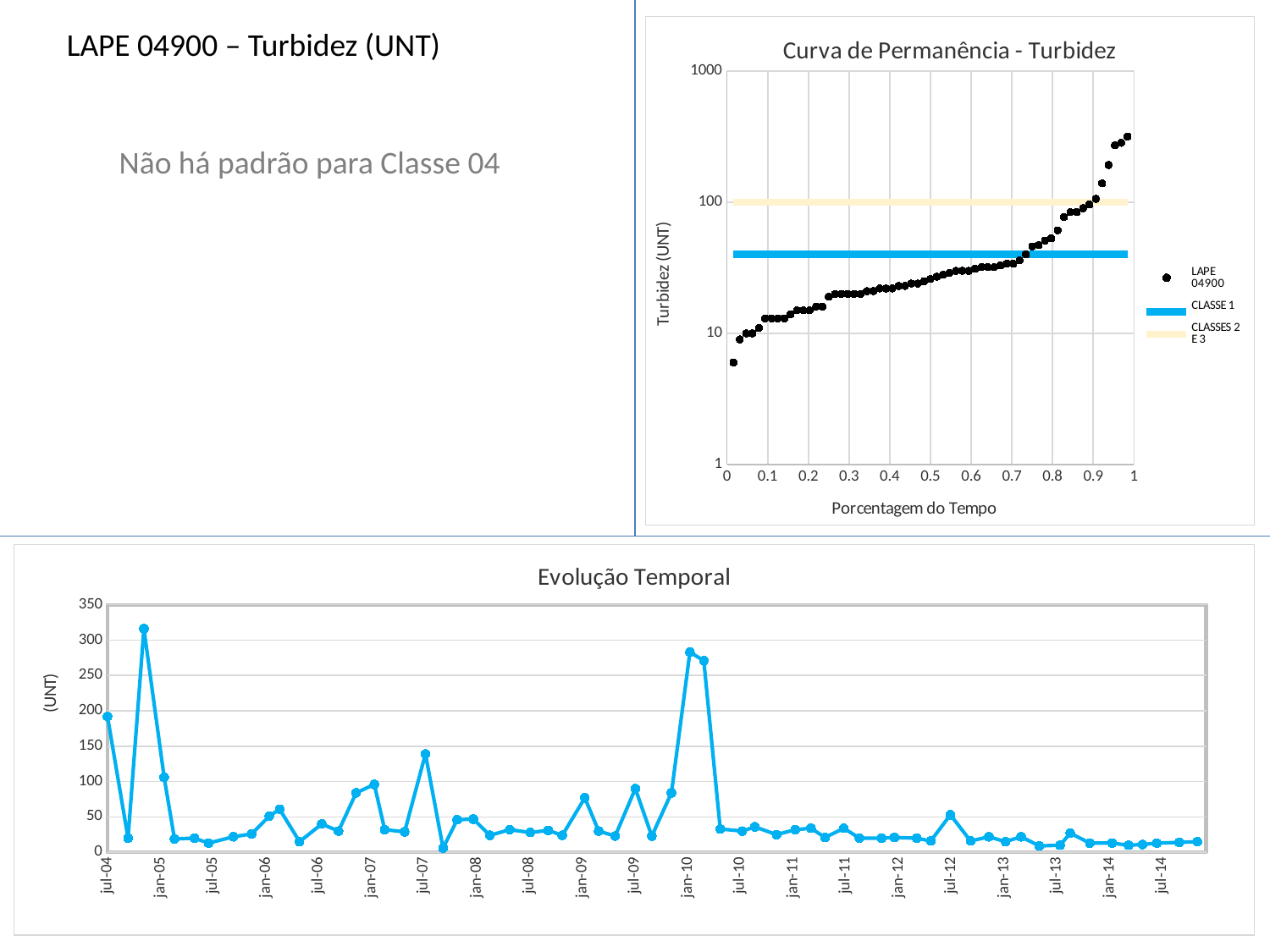
In the 'Evolução Temporal' chart, is the value at jul-04 greater or less than 150? greater In the 'Evolução Temporal' chart, is the highest value greater or less than 300? greater In the 'Curva de Permanência - Turbidez' chart, at what turbidity value is the CLASSES 2 E 3 line drawn? 100 In the 'Curva de Permanência - Turbidez' chart, is the first LAPE 04900 point (near 0 on the x axis) greater or less than 10? less What kind of chart is the 'Evolução Temporal' chart? line chart What is the x-axis title of the 'Curva de Permanência - Turbidez' chart? Porcentagem do Tempo In the 'Curva de Permanência - Turbidez' chart, what are the three legend entries? LAPE 04900, CLASSE 1, CLASSES 2 E 3 In the 'Evolução Temporal' chart, which is larger, the value at jul-04 or the value at jul-14? jul-04 How many series does the legend of the 'Curva de Permanência - Turbidez' chart list? 3 In the 'Curva de Permanência - Turbidez' chart, do the LAPE 04900 values rise or fall as Porcentagem do Tempo increases? rise